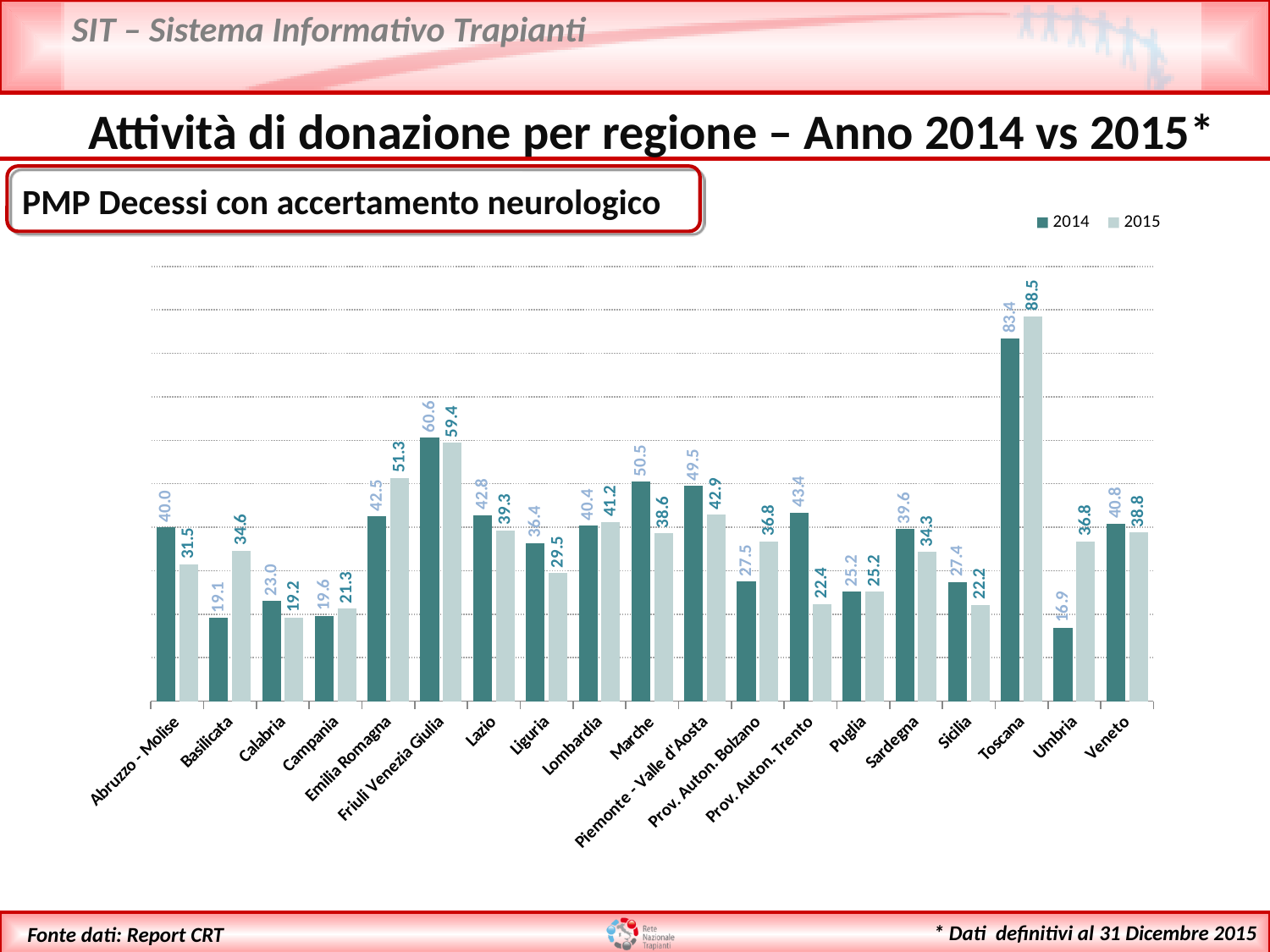
What is the difference between the 2015 and 2014 values for Basilicata? 15.5 Which region has the lowest 2015 value? Calabria How many series does the legend list? 2 What kind of chart is shown on the slide? Bar chart What is the 2014 value for Toscana? 83.4 What is the 2015 value for Emilia Romagna? 51.3 What is the difference between the 2014 and 2015 values for Prov. Auton. Trento? 21.0 Which is larger for Marche, the 2014 value or the 2015 value? 2014 What is the 2015 value for Umbria? 36.8 How many regions are shown on the x axis? 19 Which region has the highest 2015 value? Toscana Which region has the lowest 2014 value? Umbria